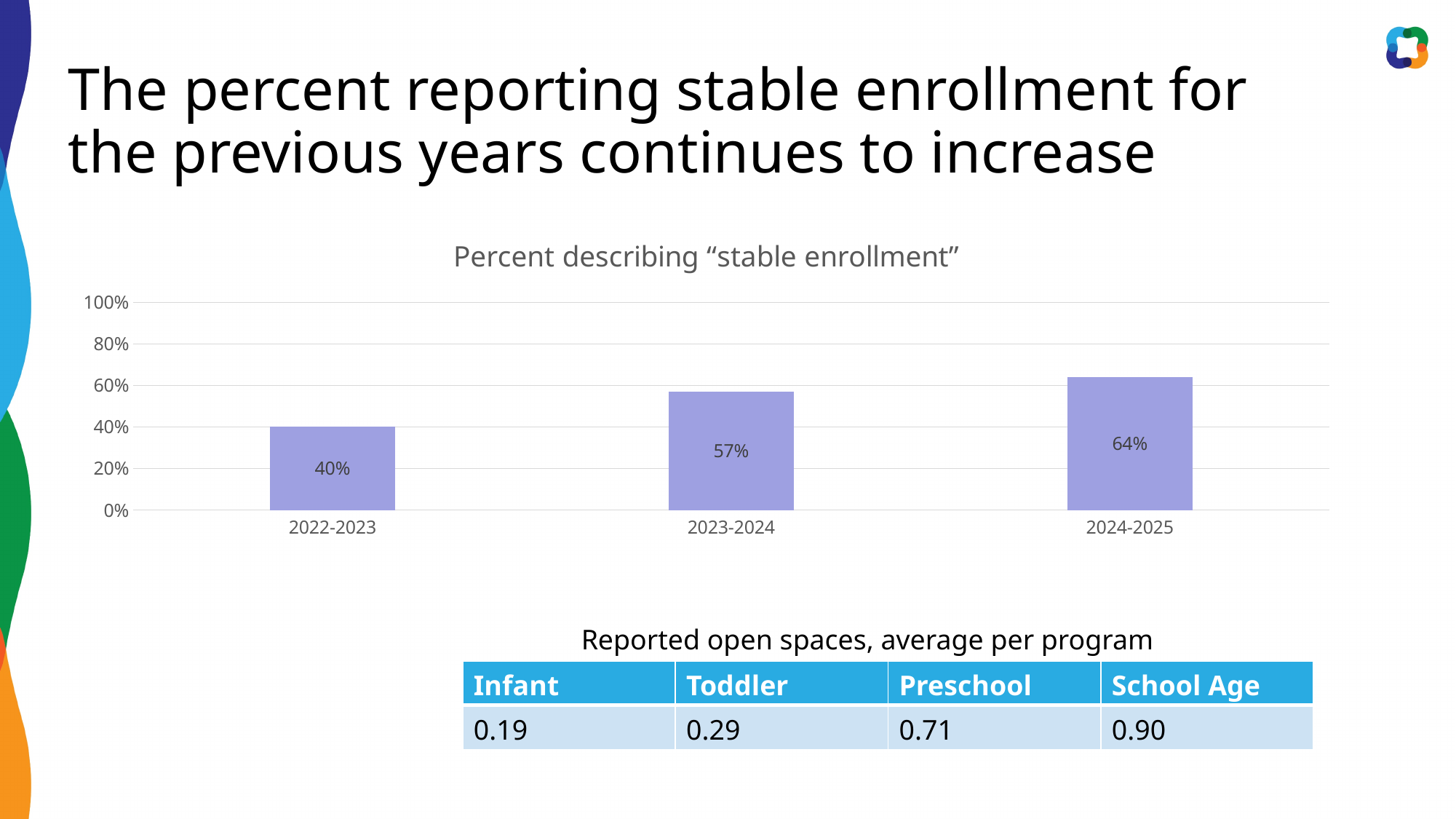
What is the value for 2024-2025? 64% Do the values rise or fall from 2022-2023 to 2024-2025? rise Which year has the highest percent describing stable enrollment? 2024-2025 What kind of chart is shown on the slide? bar chart What is the value for 2022-2023? 40% How many years are shown on the chart? 3 Is the value for 2023-2024 greater or less than 60%? less Which is larger, the value for 2023-2024 or the value for 2024-2025? 2024-2025 What is the value for 2023-2024? 57% What is the difference between the values for 2024-2025 and 2022-2023? 24% What is the difference between the values for 2023-2024 and 2022-2023? 17% Which year has the lowest percent describing stable enrollment? 2022-2023